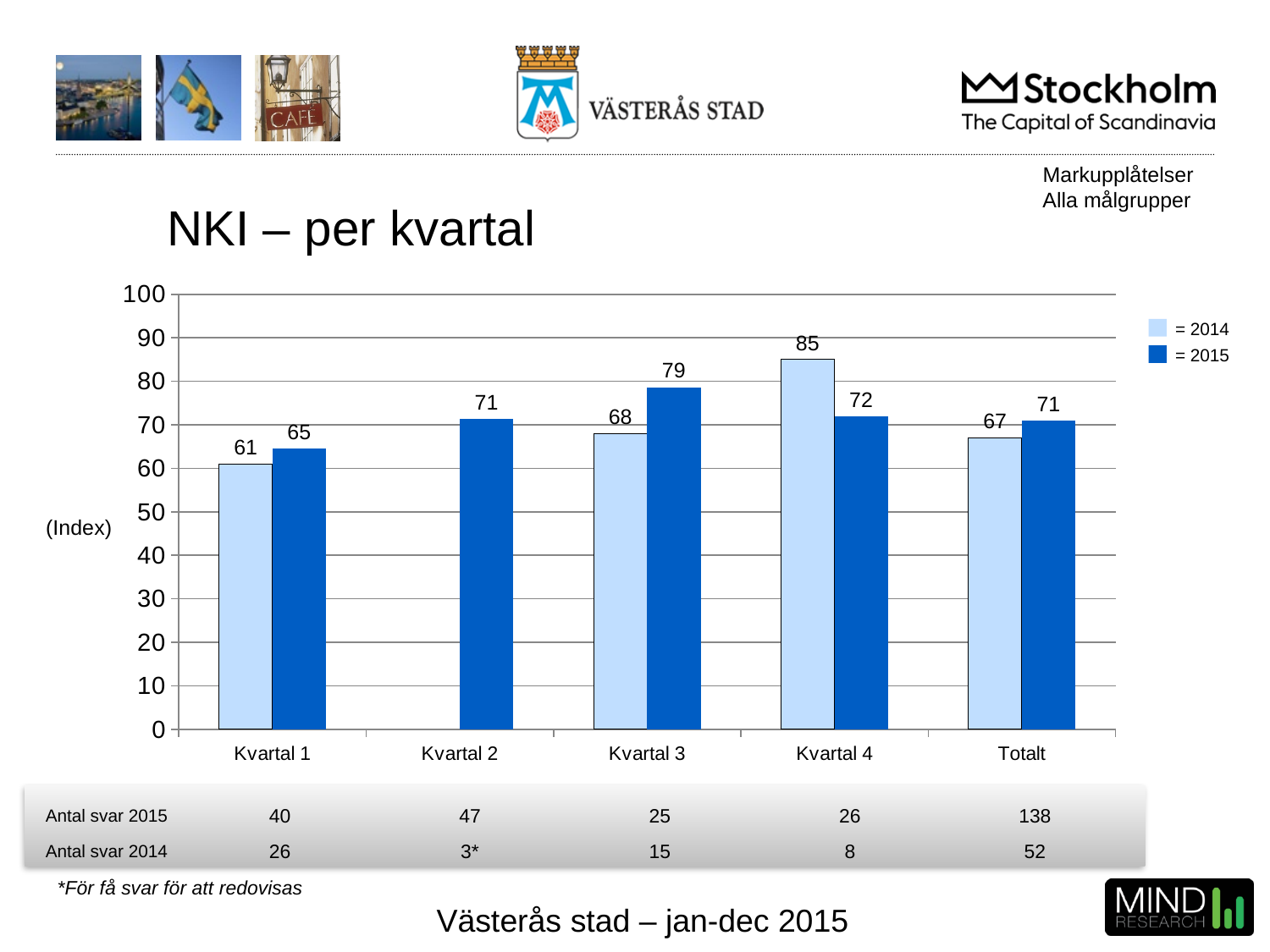
How many series does the legend list? 2 What is the title of the chart? NKI – per kvartal Which category has the highest 2014 value? Kvartal 4 What kind of chart is shown on the slide? bar chart Which category has the lowest 2015 value? Kvartal 1 What is the 2015 value for Totalt? 71 How many categories are shown on the x axis? 5 What is the 2014 value for Kvartal 4? 85 What is the 2015 value for Kvartal 3? 79 Which is larger for Kvartal 4, the 2014 value or the 2015 value? 2014 Which category has no 2014 bar shown? Kvartal 2 What is the difference between the 2015 and 2014 values for Kvartal 3? 11